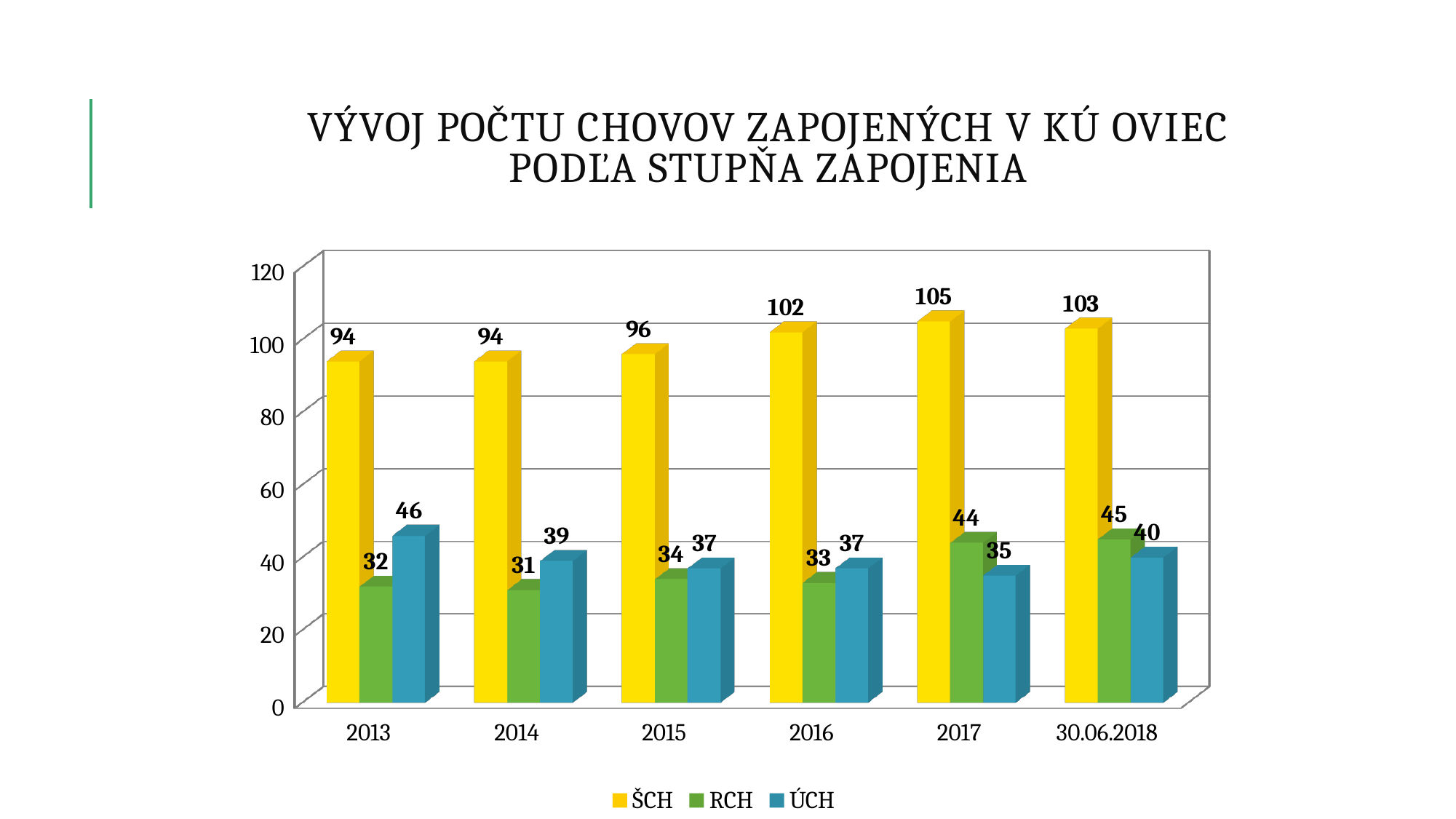
Which is larger in 2017: the RCH value or the ÚCH value? RCH What kind of chart is shown on the slide? Bar chart How many categories are shown on the x axis? 6 Which series is shown in yellow? ŠCH What is the value for RCH on 30.06.2018? 45 What is the value for ŠCH in 2016? 102 In which year is the ŠCH value highest? 2017 What is the value for RCH in 2014? 31 What is the value for ÚCH in 2013? 46 How many series does the legend list? 3 In which year is the RCH value lowest? 2014 What is the difference between the ŠCH value in 2017 and the ŠCH value in 2013? 11